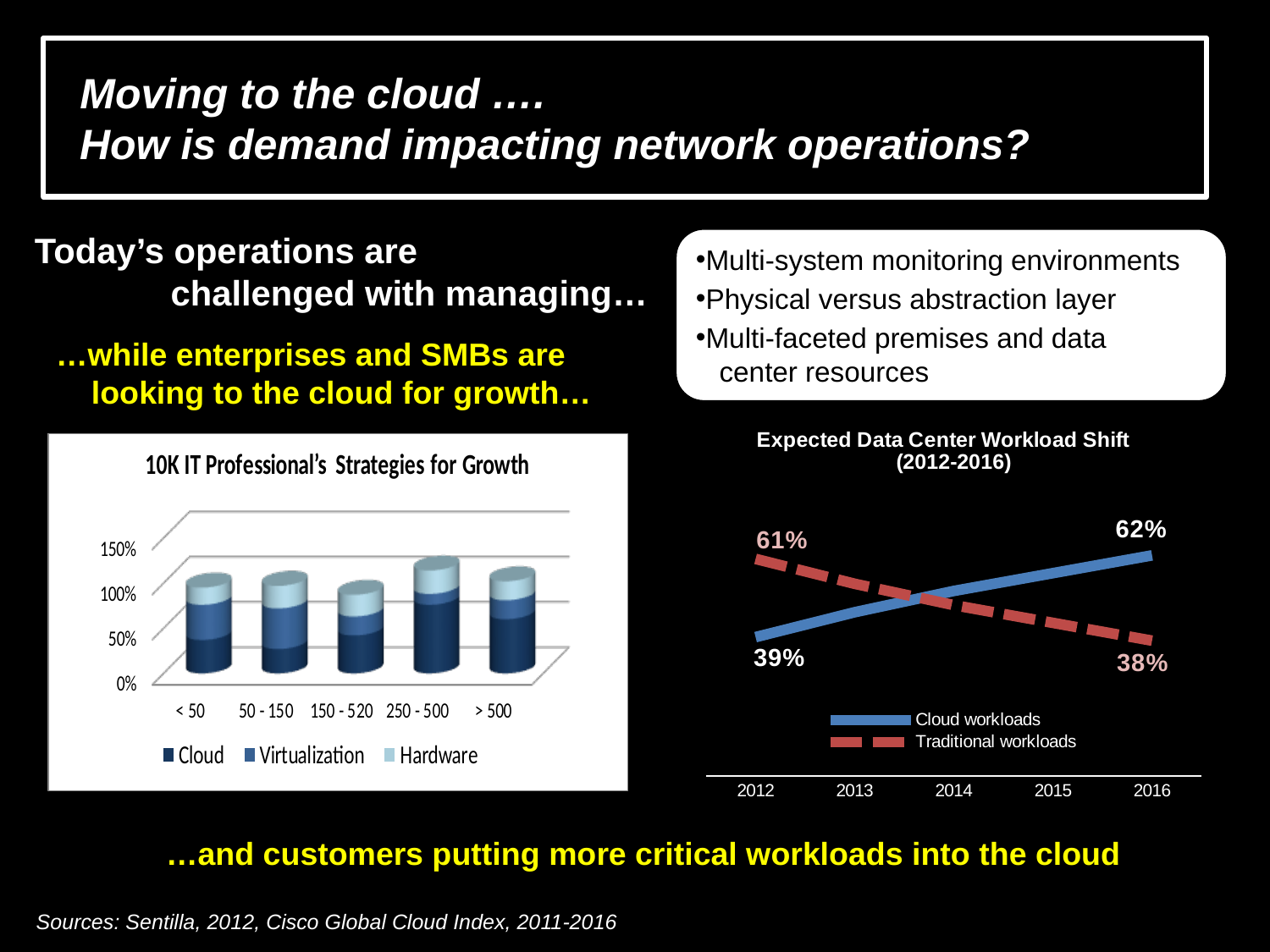
How many years are shown on the x axis of the Expected Data Center Workload Shift chart? 5 What kind of chart is the Expected Data Center Workload Shift chart? line chart In the Expected Data Center Workload Shift chart, which series has the higher value in 2016, Cloud workloads or Traditional workloads? Cloud workloads In the Expected Data Center Workload Shift chart, do Traditional workloads rise or fall from 2012 to 2016? fall In the Expected Data Center Workload Shift chart, what is the value for Traditional workloads in 2016? 38% How many series does the legend of the 10K IT Professional's Strategies for Growth chart list? 3 What kind of chart is the 10K IT Professional's Strategies for Growth chart? stacked bar chart In the Expected Data Center Workload Shift chart, by how many percentage points do Cloud workloads increase from 2012 to 2016? 23 percentage points In the Expected Data Center Workload Shift chart, what is the value for Cloud workloads in 2012? 39% In the Expected Data Center Workload Shift chart, what is the value for Traditional workloads in 2012? 61% In the 10K IT Professional's Strategies for Growth chart, which category has the tallest stacked bar? 250 - 500 In the Expected Data Center Workload Shift chart, what is the value for Cloud workloads in 2016? 62%